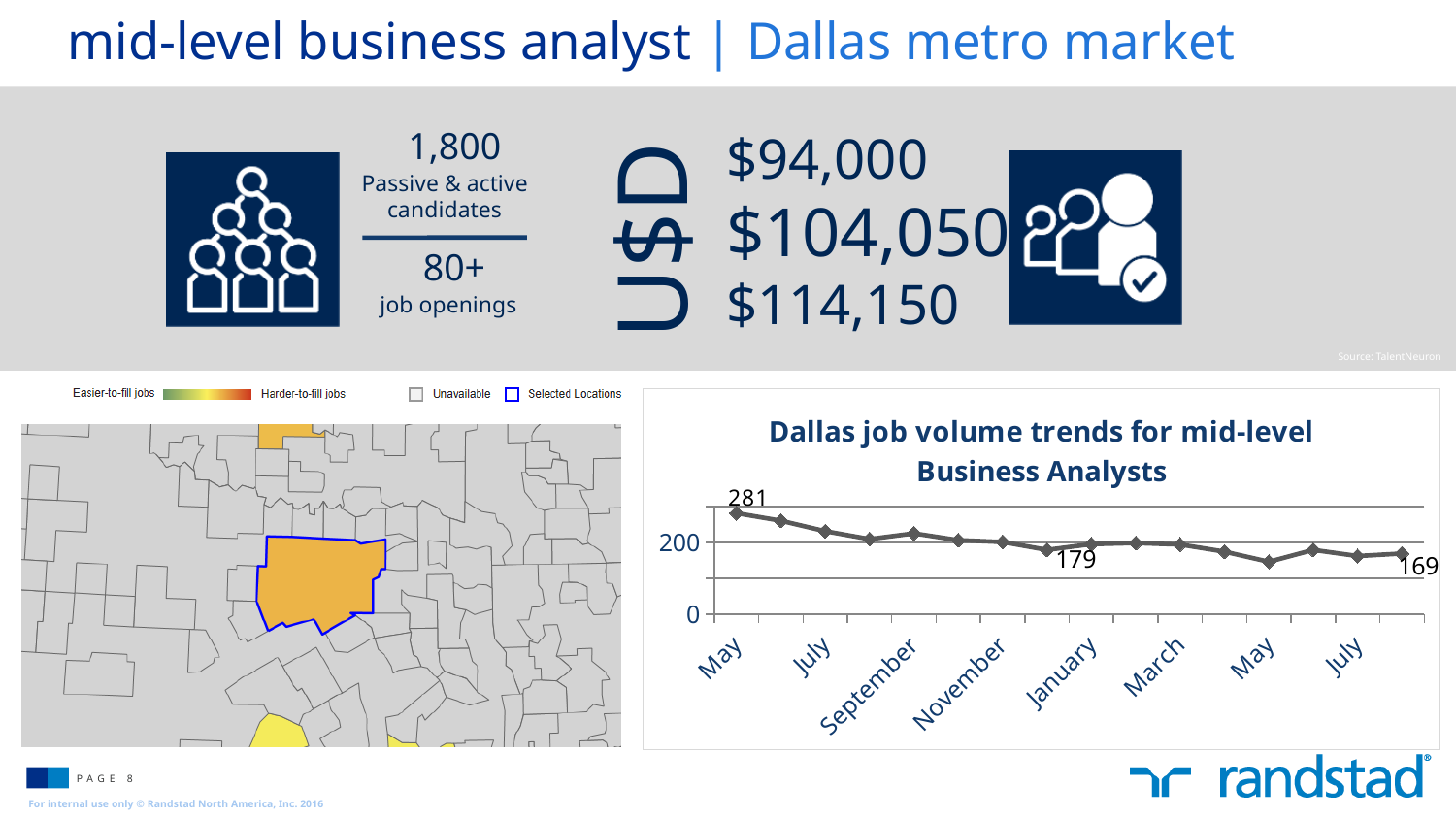
In the Dallas job volume trends chart, do the values generally rise or fall from left to right? fall In the Dallas job volume trends chart, what is the value at the first May point? 281 In the Dallas job volume trends chart, what is the difference between the first point (281) and the last point (169)? 112 In the Dallas job volume trends chart, what is the value of the last point on the line? 169 In the Dallas job volume trends chart, which is larger: the first May value or the last point's value? the first May value (281) What is the title of the line chart on the slide? Dallas job volume trends for mid-level Business Analysts In the Dallas job volume trends chart, which month has the highest job volume? May (the first point) What kind of chart is 'Dallas job volume trends for mid-level Business Analysts'? line chart In the Dallas job volume trends chart, is the value for the second July greater or less than 200? less How many lines are plotted in the Dallas job volume trends chart? 1